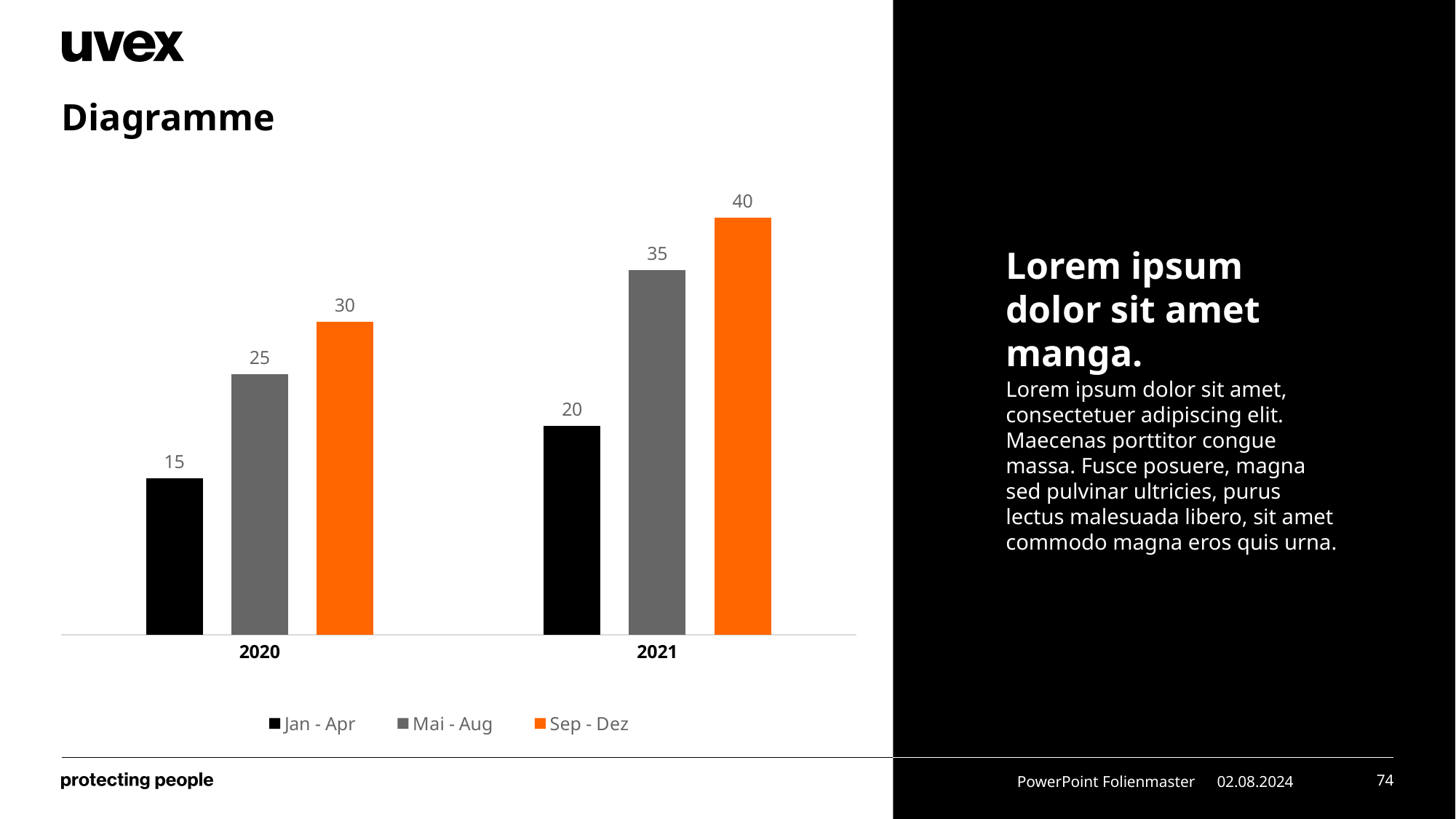
How many categories are shown on the x axis? 2 What kind of chart is shown on the slide? Bar chart Which series has the lowest value in 2020? Jan - Apr What is the value for Sep - Dez in 2021? 40 Which is larger: Mai - Aug in 2020 or Jan - Apr in 2021? Mai - Aug in 2020 What is the difference between the Sep - Dez values for 2021 and 2020? 10 How many series does the legend list? 3 What colour are the Sep - Dez bars? Orange What is the value for Jan - Apr in 2020? 15 Which series has the highest value in 2021? Sep - Dez What is the value for Mai - Aug in 2021? 35 Do the Jan - Apr values rise or fall from 2020 to 2021? Rise